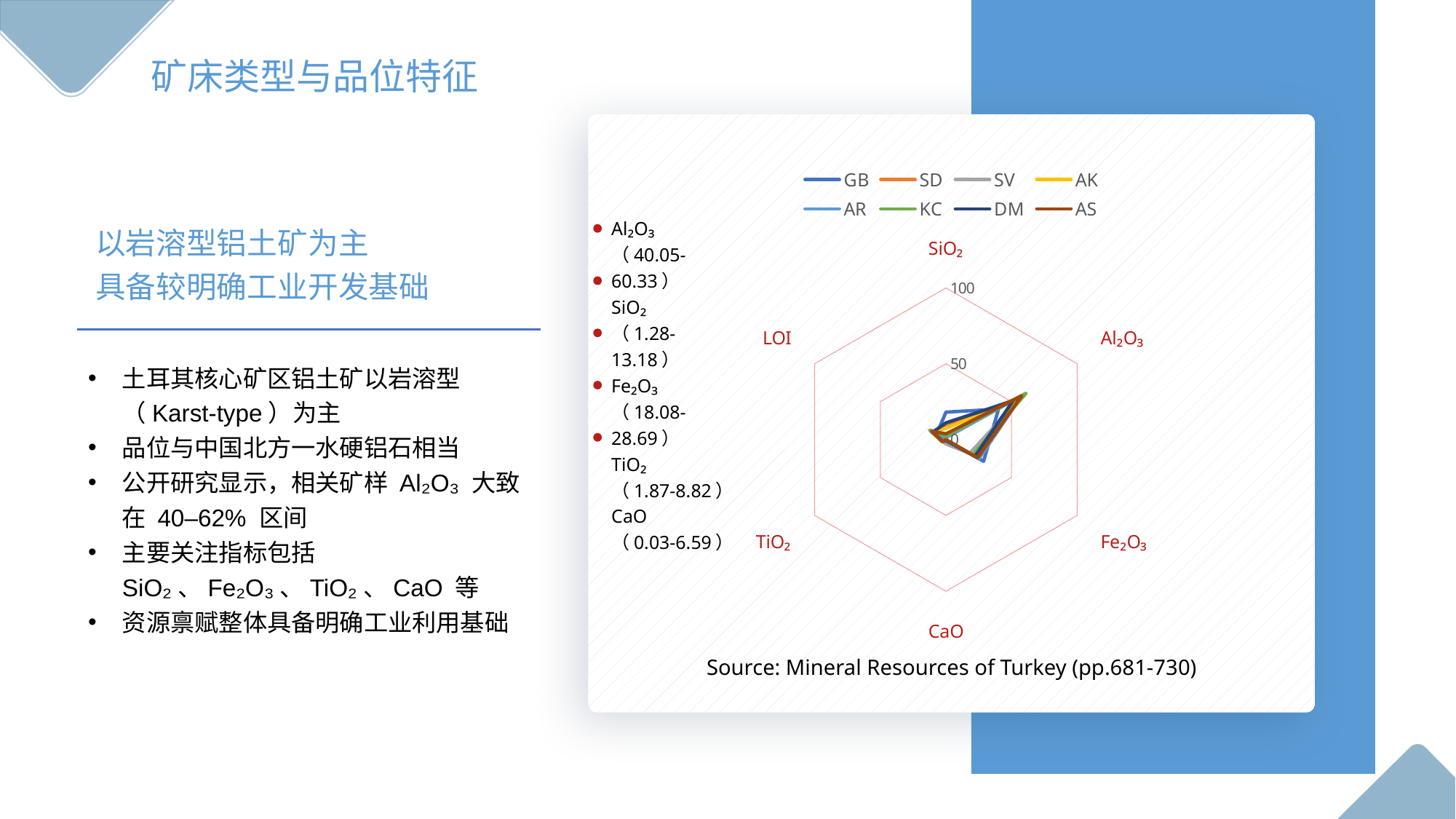
Are the values for TiO₂ greater or less than 50? less Which series is listed first in the chart legend? GB What kind of chart is shown on the slide? Radar chart Are the values for Fe₂O₃ greater or less than 50? less What is the maximum value shown on the radar chart's scale? 100 How many axes (categories) does the radar chart have? 6 Are the values for SiO₂ greater or less than 50? less On which axis do the series reach their highest values? Al₂O₃ Which axis has larger values, Al₂O₃ or CaO? Al₂O₃ How many series does the chart legend list? 8